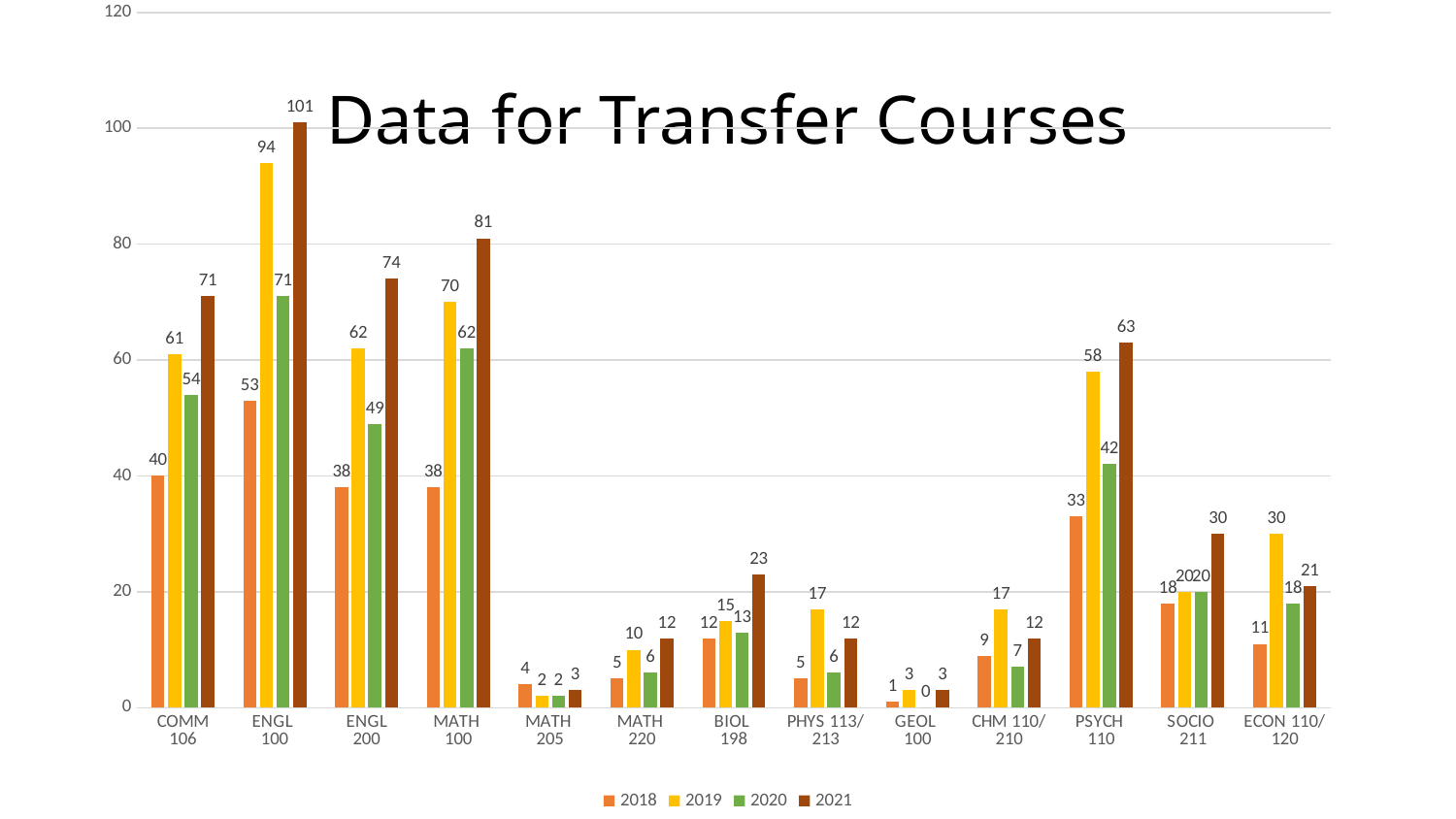
How many series does the legend list? 4 Which course has the lowest 2020 value? GEOL 100 How many courses are shown on the x axis? 13 What kind of chart is shown on the slide? Bar chart Is the 2021 value for MATH 100 greater or less than 80? greater What is the 2020 value for MATH 100? 62 Which course has the highest 2019 value? ENGL 100 What is the difference between the 2021 and 2018 values for COMM 106? 31 What is the title of the chart? Data for Transfer Courses Which is larger for ECON 110/120: the 2019 value or the 2021 value? 2019 What is the 2021 value for ENGL 100? 101 What is the 2018 value for PSYCH 110? 33